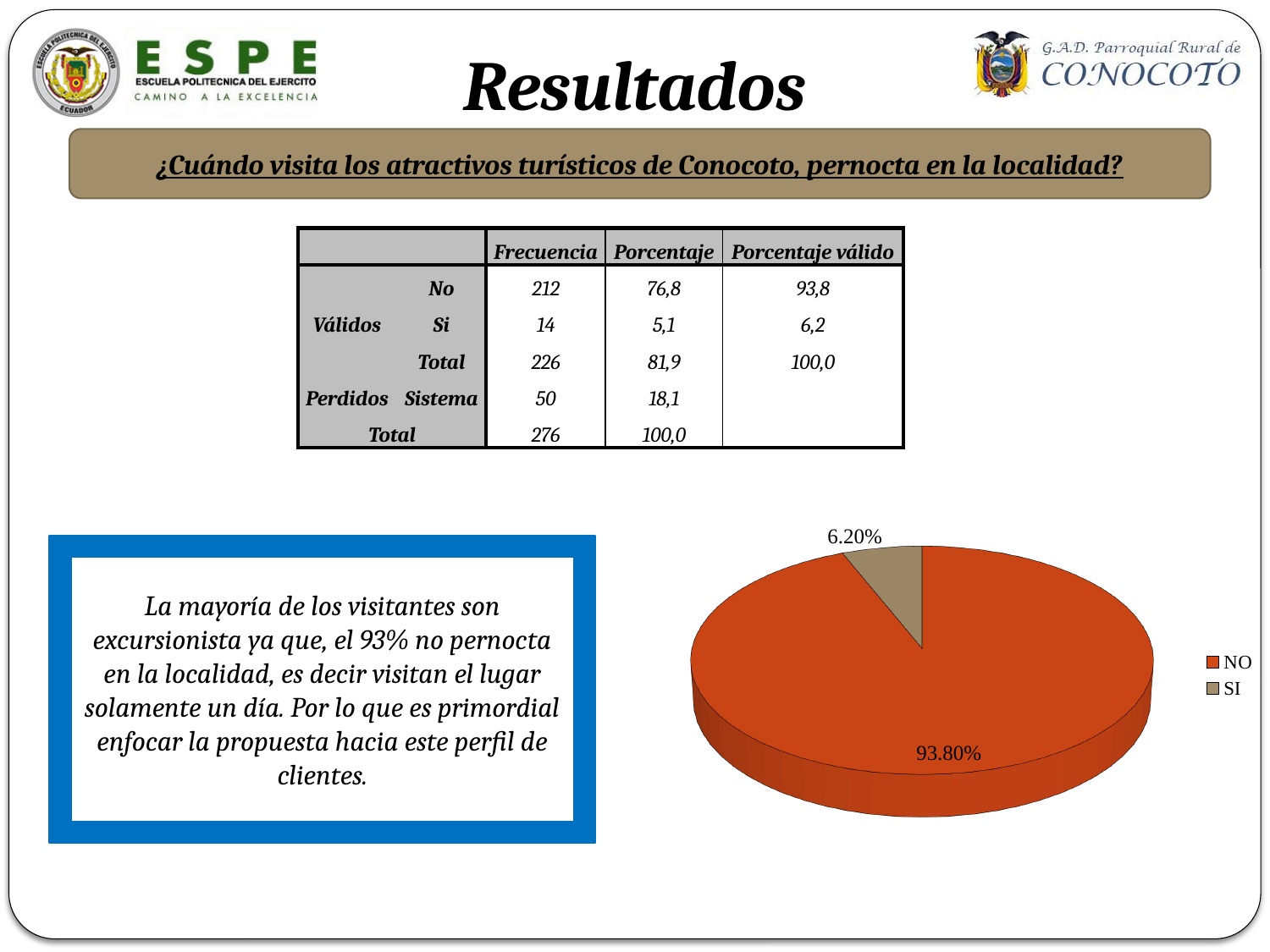
Which slice of the pie chart is the largest? NO What is the difference in percentage points between the NO slice and the SI slice? 87.60% How many slices does the pie chart have? 2 What colour is the NO slice in the pie chart? orange-red What share of the pie does the NO slice represent? 93.80% Which is larger in the pie chart, the NO slice or the SI slice? NO Which slice of the pie chart is the smallest? SI What share of the pie does the SI slice represent? 6.20% What colour is the SI slice in the pie chart? tan/beige How many entries does the legend of the pie chart list? 2 What kind of chart is shown on the slide? pie chart